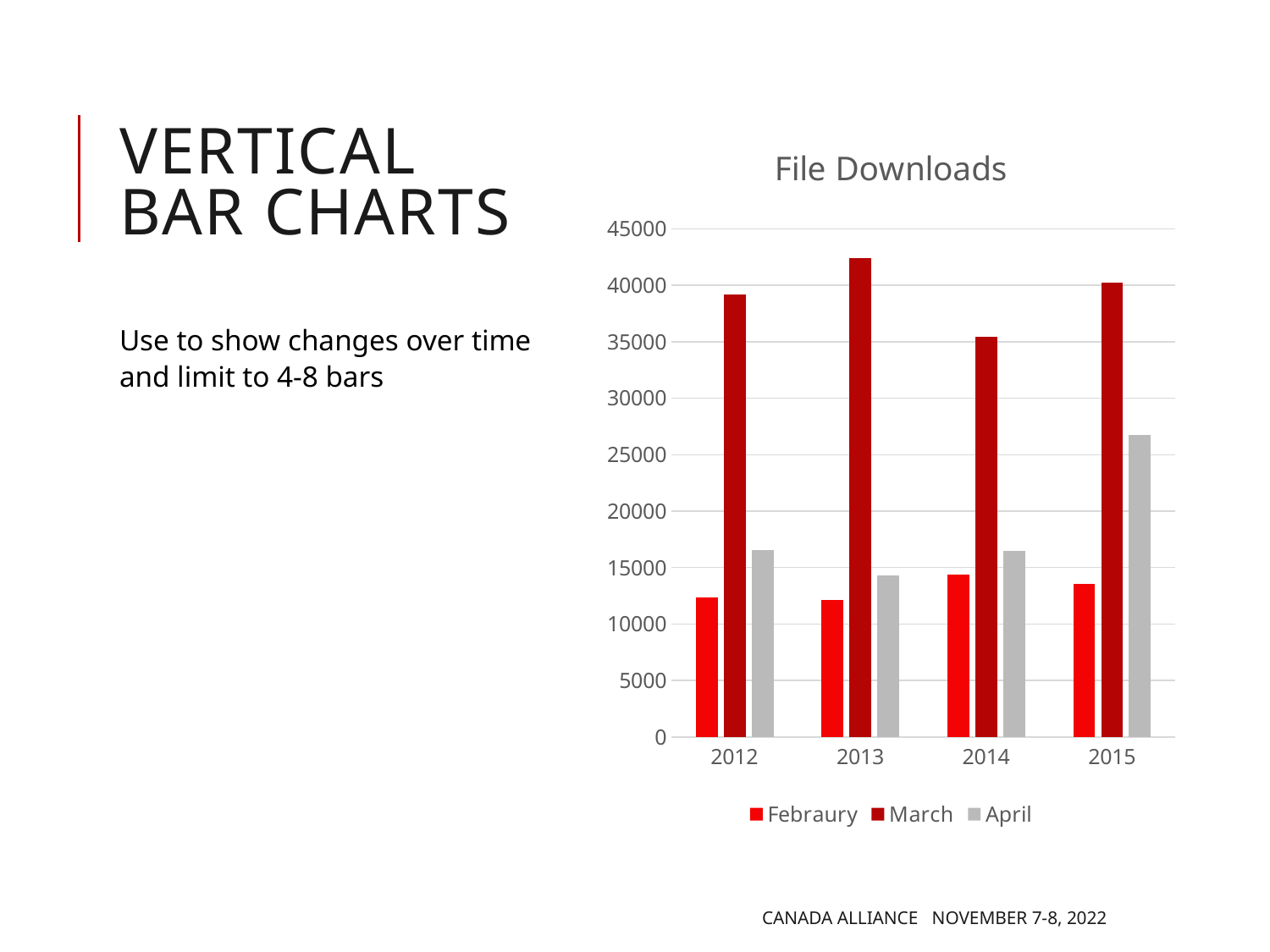
How many series does the legend list? 3 Is the April value for 2015 greater or less than 25000? greater In which year is the April value highest? 2015 What is the title of the chart? File Downloads How many years are shown on the x axis? 4 In which year is the March value lowest? 2014 Which series is shown in grey in the legend? April In which year is the March value highest? 2013 Is the March value for 2014 greater or less than 40000? less Is the March value for 2013 greater or less than 40000? greater Which is larger in 2012, the March value or the April value? March What kind of chart is shown on the slide? bar chart